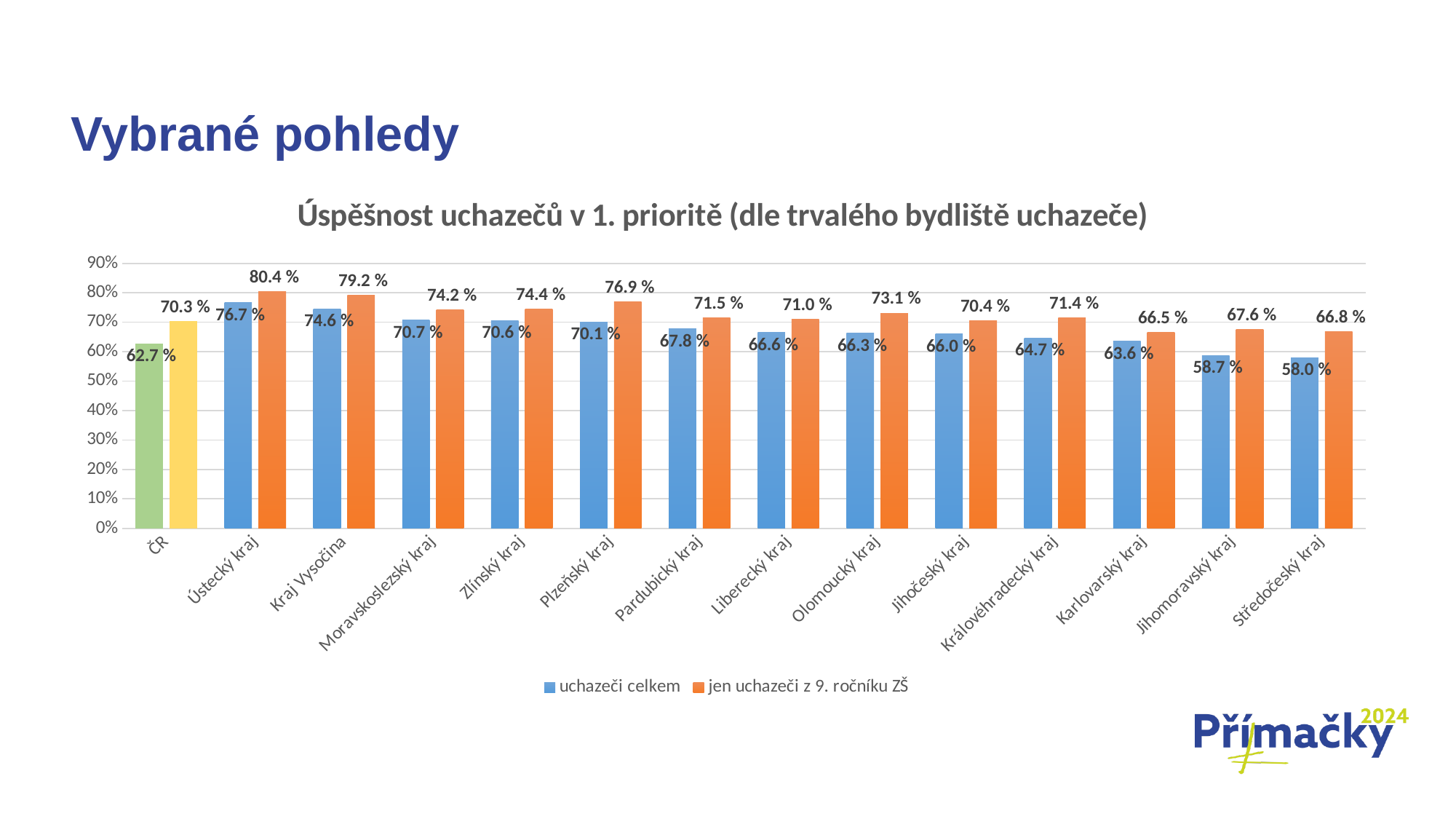
What is the 'uchazeči celkem' value for ČR? 62.7 % What is the title of the chart? Úspěšnost uchazečů v 1. prioritě (dle trvalého bydliště uchazeče) How many series does the legend list? 2 Which is larger: the 'uchazeči celkem' value for Kraj Vysočina or for Moravskoslezský kraj? Kraj Vysočina What is the difference between the 'jen uchazeči z 9. ročníku ZŠ' and 'uchazeči celkem' values for Plzeňský kraj? 6.8 % Is the 'uchazeči celkem' value for Jihomoravský kraj greater or less than 60%? less What is the value for Středočeský kraj in the 'uchazeči celkem' series? 58.0 % What kind of chart is shown on the slide? bar chart Which category has the lowest value in the 'uchazeči celkem' series? Středočeský kraj What is the value for Ústecký kraj in the 'jen uchazeči z 9. ročníku ZŠ' series? 80.4 % How many categories are shown on the x axis? 14 Which category has the highest value in the 'jen uchazeči z 9. ročníku ZŠ' series? Ústecký kraj